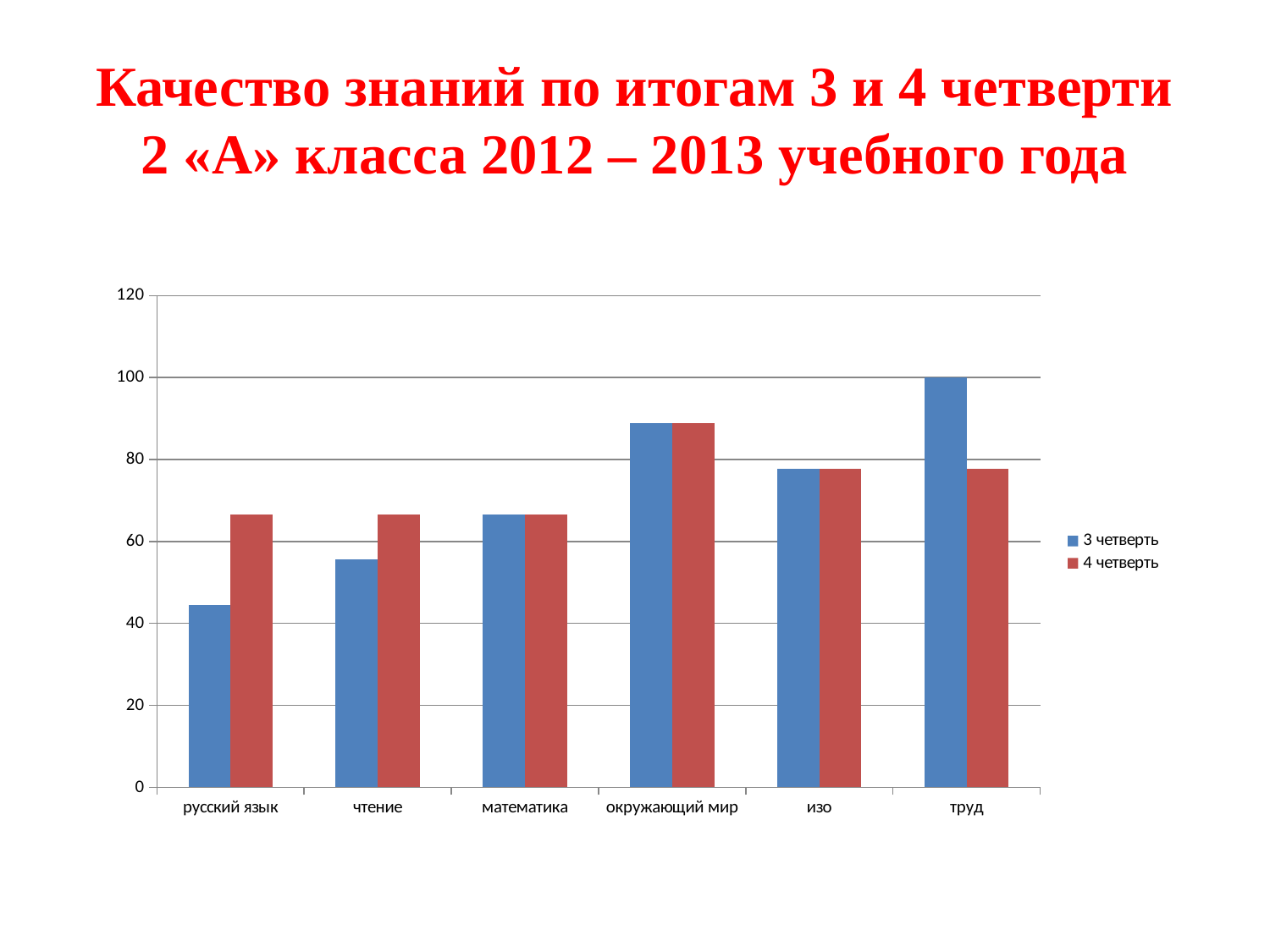
Is the 3 четверть value for окружающий мир greater or less than 80? greater How many subjects (categories) are shown on the x axis of the chart? 6 What is the value for труд in the 3 четверть series? 100 For труд, which is larger: the 3 четверть value or the 4 четверть value? 3 четверть Which subject has the highest value in the 4 четверть series? окружающий мир What type of chart is shown on the slide? bar chart Is the 3 четверть value for русский язык greater or less than 60? less How many series does the chart legend list? 2 Which colour represents the 3 четверть series in the chart? blue Which subject has the highest value in the 3 четверть series? труд Which subject has the lowest value in the 3 четверть series? русский язык For русский язык, which is larger: the 3 четверть value or the 4 четверть value? 4 четверть